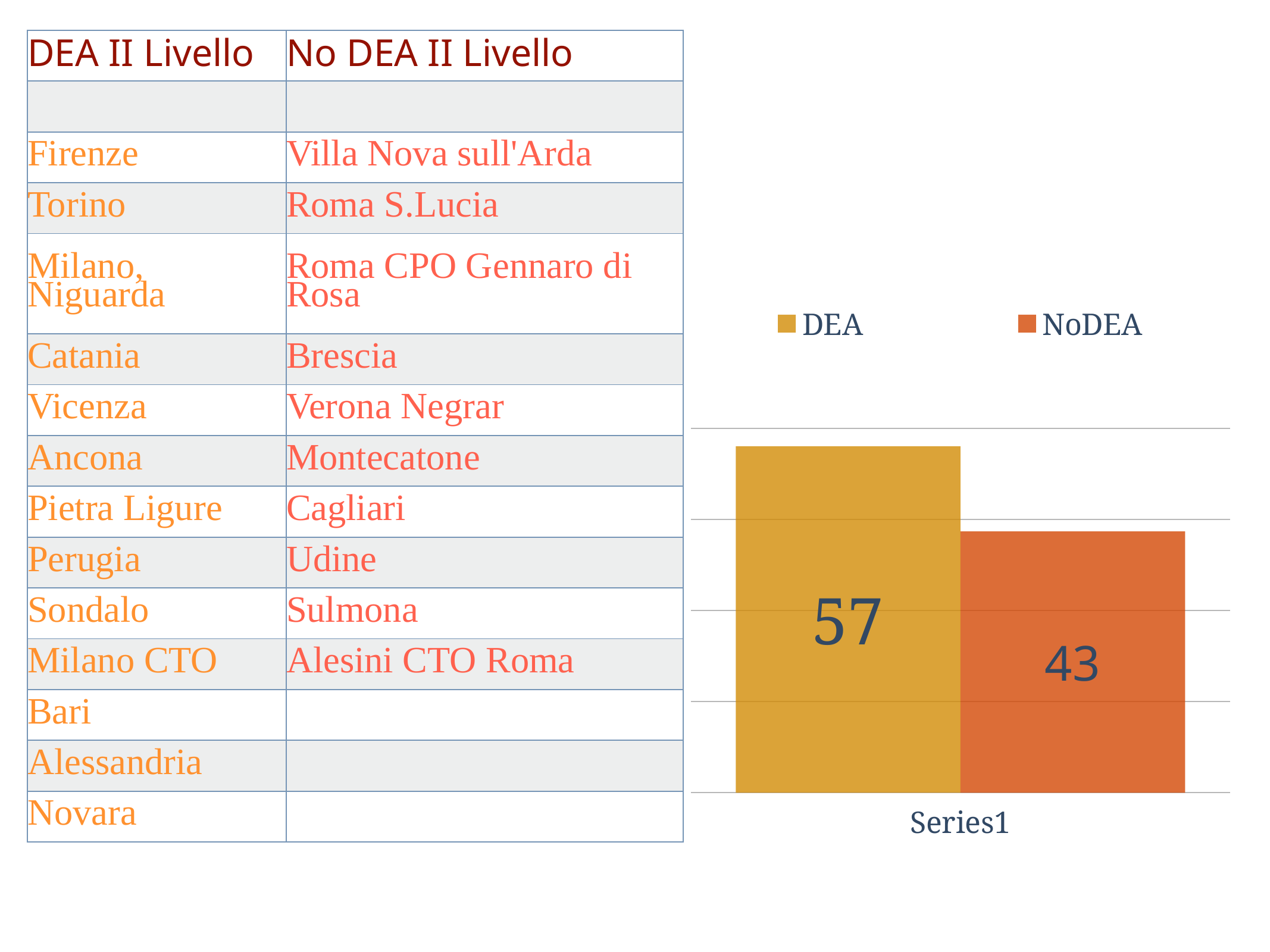
What is the value for NoDEA in the chart? 43 What is the value for DEA in the chart? 57 What is the total of the DEA and NoDEA values? 100 What is the difference between the DEA and NoDEA values? 14 What kind of chart is shown on the slide? Bar chart What is the category label shown on the x axis of the chart? Series1 What colour is the DEA bar in the chart? Yellow/gold How many series does the chart legend list? 2 Which series has the higher value, DEA or NoDEA? DEA Which series has the lowest value in the chart? NoDEA